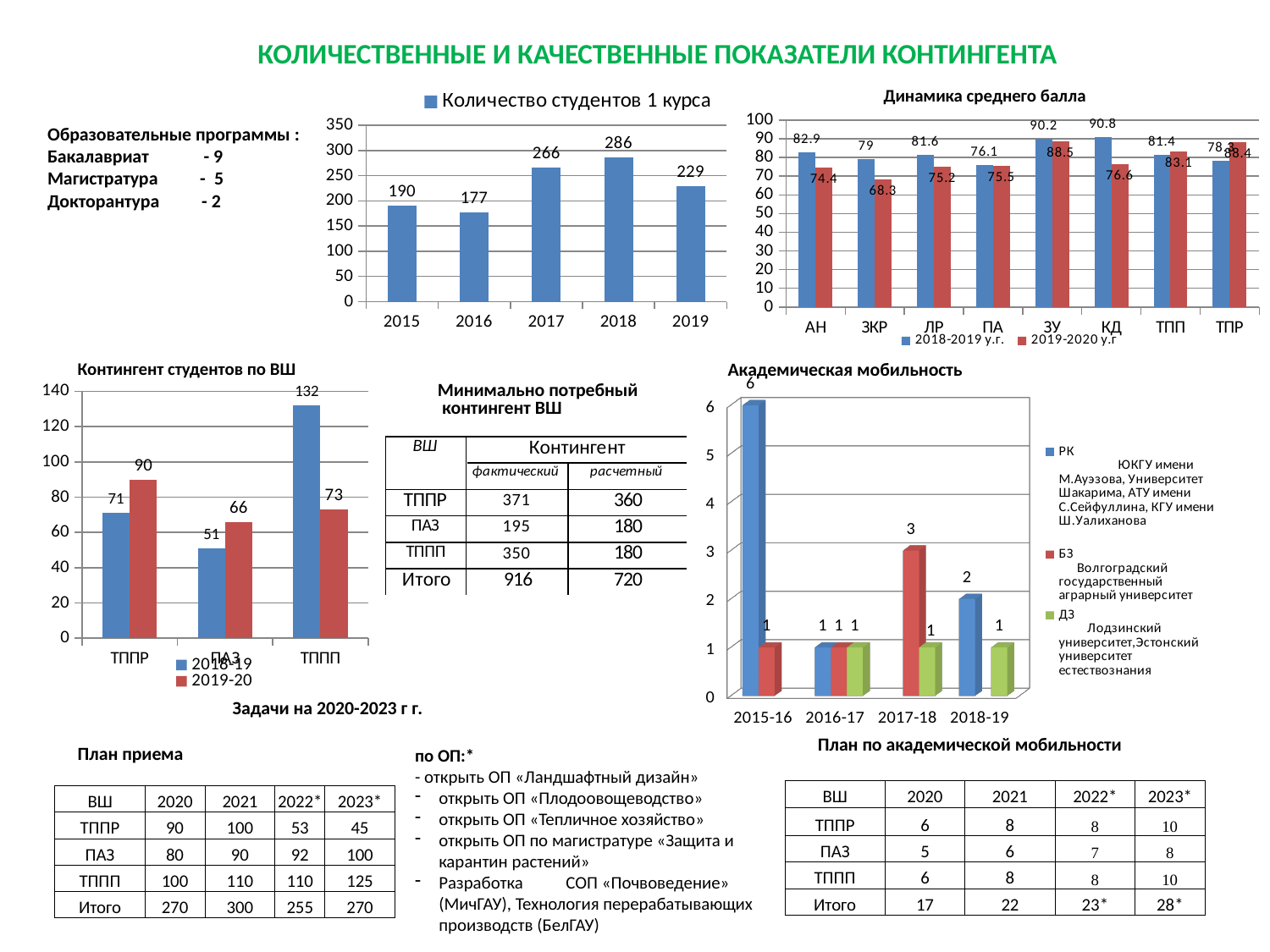
In the chart 'Количество студентов 1 курса', how many years are shown on the x axis? 5 In the chart 'Динамика среднего балла', which category has the highest value in the 2018-2019 у.г. series? КД What kind of chart is 'Академическая мобильность'? bar chart In the chart 'Академическая мобильность', what is the value for БЗ in 2017-18? 3 In the chart 'Количество студентов 1 курса', what is the difference between the values for 2018 and 2019? 57 In the chart 'Динамика среднего балла', is the 2018-2019 у.г. value for АН larger or the 2019-2020 у.г. value for АН? 2018-2019 у.г. In the chart 'Динамика среднего балла', how many series does the legend list? 2 In the chart 'Количество студентов 1 курса', how many first-year students were there in 2018? 286 In the chart 'Количество студентов 1 курса', which year has the lowest number of students? 2016 In the chart 'Динамика среднего балла', what is the value for ЗКР in the 2019-2020 у.г. series? 68.3 In the chart 'Контингент студентов по ВШ', what is the difference between the 2019-20 and 2018-19 values for ТППР? 19 In the chart 'Контингент студентов по ВШ', what is the value for ТППП in the 2018-19 series? 132